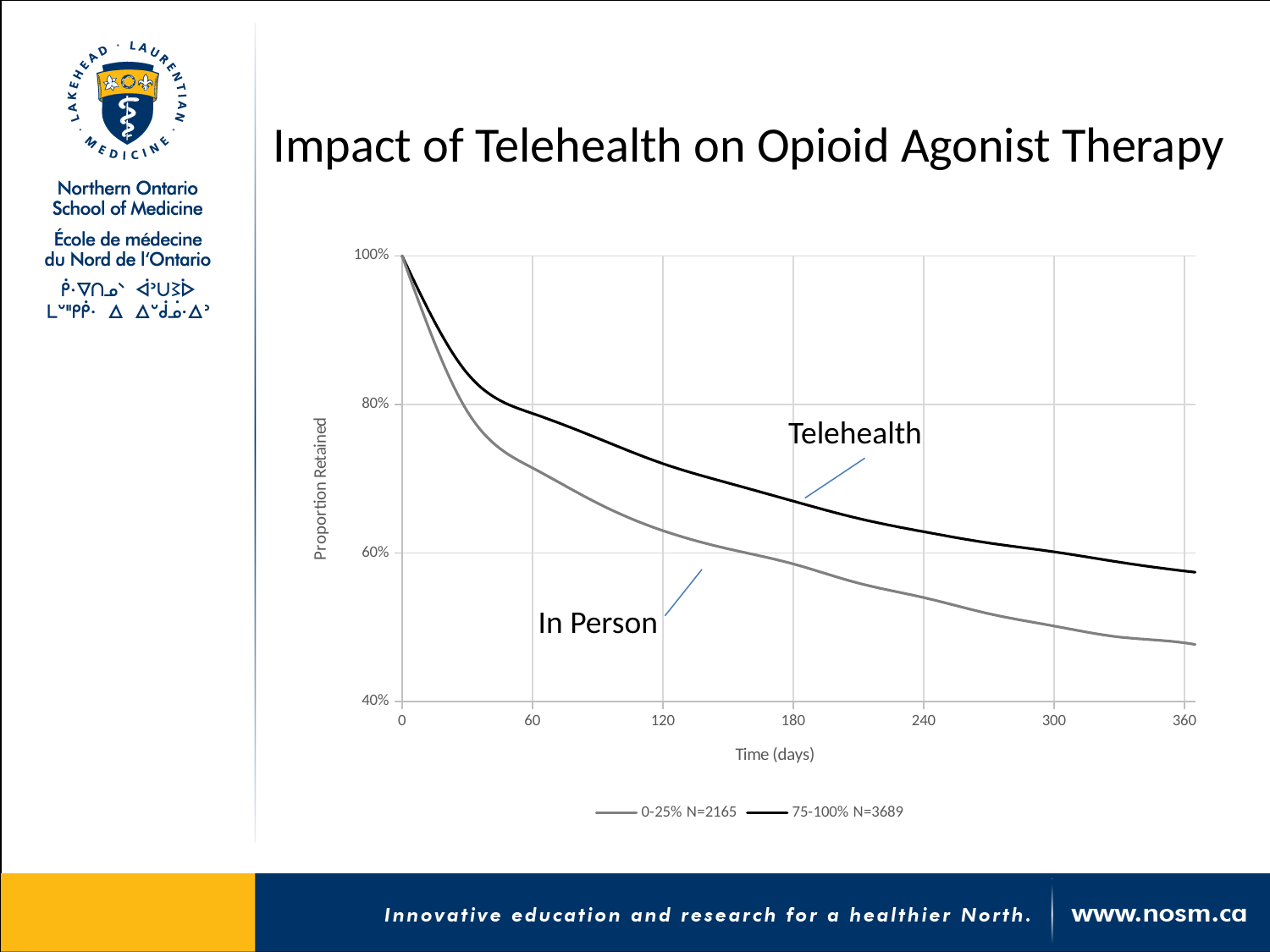
At 180 days, which line is higher: Telehealth or In Person? Telehealth Is the value for In Person at 360 days greater or less than 60%? less What is the proportion retained for both series at 0 days? 100% Which series has the higher proportion retained at 360 days? Telehealth Is the value for In Person at 240 days greater or less than 60%? less Is the value for Telehealth at 120 days greater or less than 80%? less What are the two legend entries in the chart? 0-25% N=2165 and 75-100% N=3689 What is the label on the vertical axis of the chart? Proportion Retained How many series does the legend list? 2 Do the proportion retained values rise or fall as time in days increases? fall What kind of chart is shown on the slide? line chart